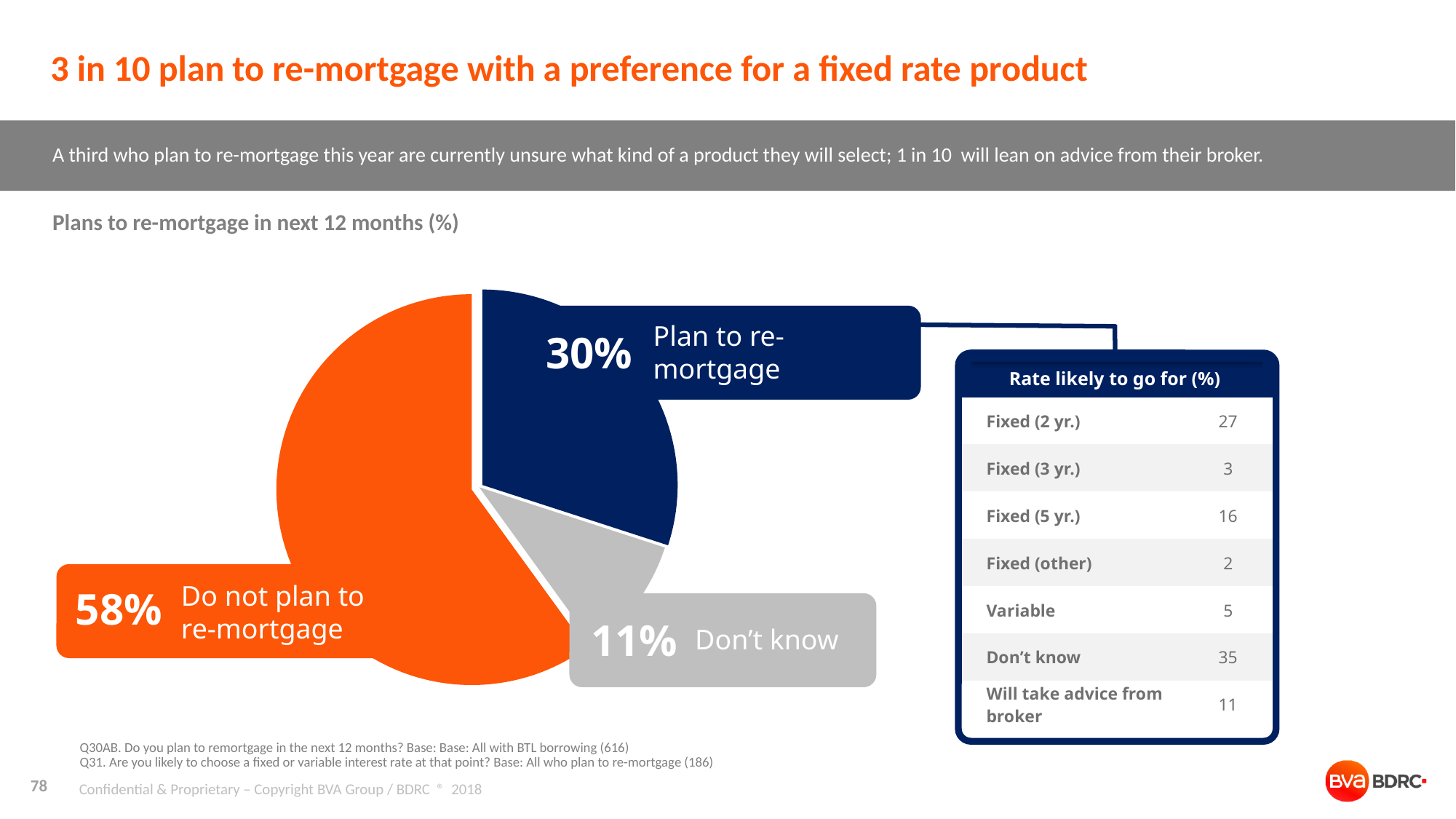
What percentage of respondents do not plan to re-mortgage? 58% What percentage of respondents answered 'Don't know' about re-mortgaging? 11% What colour is the 'Do not plan to re-mortgage' slice of the pie chart? orange What colour is the 'Plan to re-mortgage' slice of the pie chart? dark blue What is the difference in percentage points between 'Plan to re-mortgage' and 'Don't know'? 19 Which slice of the pie chart is the smallest? Don't know What percentage of respondents plan to re-mortgage in the next 12 months? 30% What kind of chart is shown under the heading 'Plans to re-mortgage in next 12 months (%)'? pie chart Which is larger in the pie chart: 'Plan to re-mortgage' or 'Don't know'? Plan to re-mortgage What is the difference in percentage points between 'Do not plan to re-mortgage' and 'Plan to re-mortgage'? 28 Which slice of the pie chart is the largest? Do not plan to re-mortgage How many slices does the pie chart have? 3